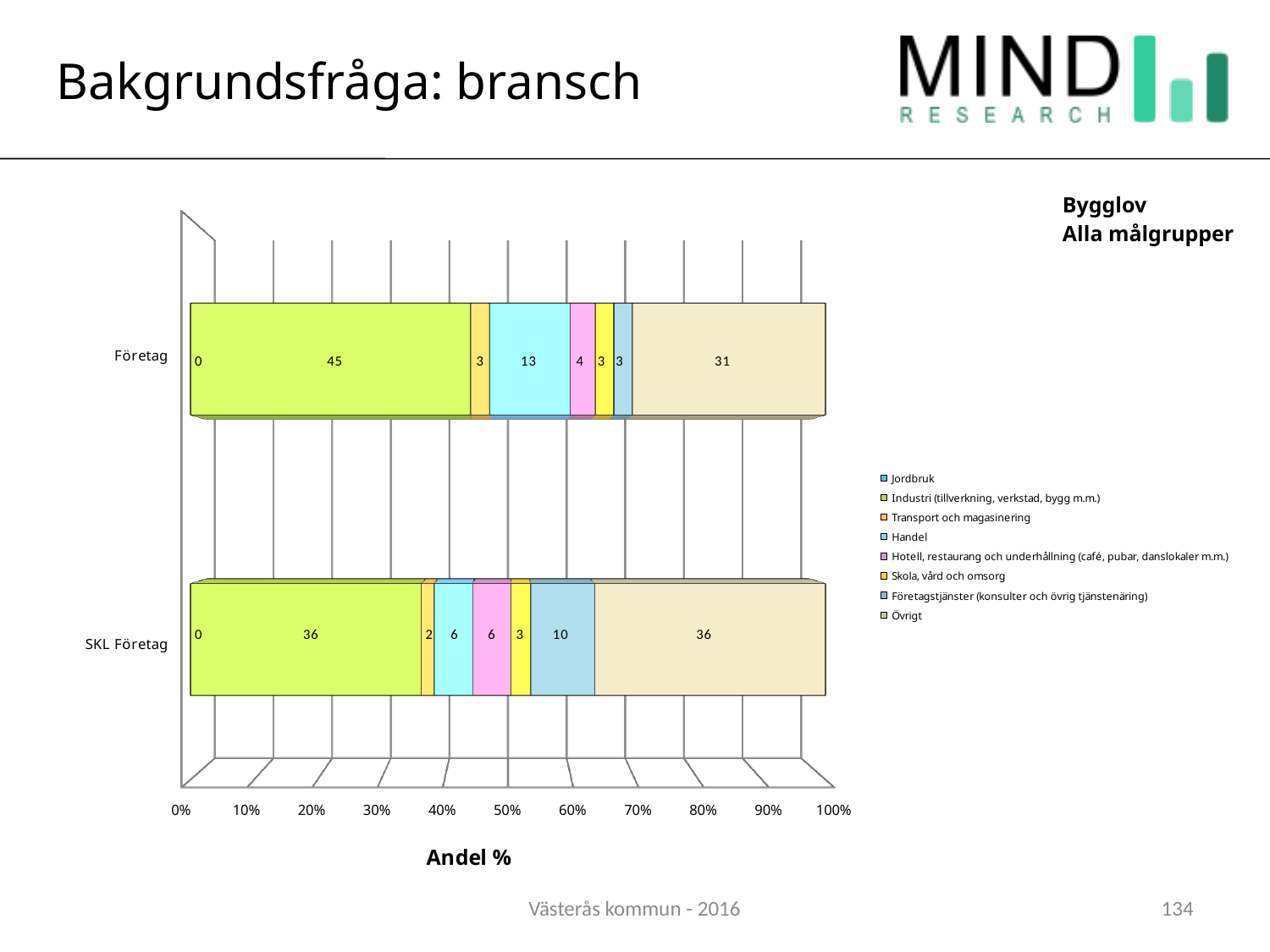
What kind of chart is shown on the slide? Stacked bar chart Which is larger: the Handel value for Företag or for SKL Företag? Företag What is the value for Handel for Företag? 13 What is the difference between the Industri values for Företag and SKL Företag? 9 Which segment is the largest in the Företag bar? Industri (tillverkning, verkstad, bygg m.m.) What is the difference between the Övrigt values for SKL Företag and Företag? 5 What is the value for Övrigt for SKL Företag? 36 What is the value for Företagstjänster (konsulter och övrig tjänstenäring) for SKL Företag? 10 How many categories (bars) are shown on the y axis? 2 What is the value for Industri (tillverkning, verkstad, bygg m.m.) for Företag? 45 What is the x-axis title of the chart? Andel % How many series does the legend list? 8